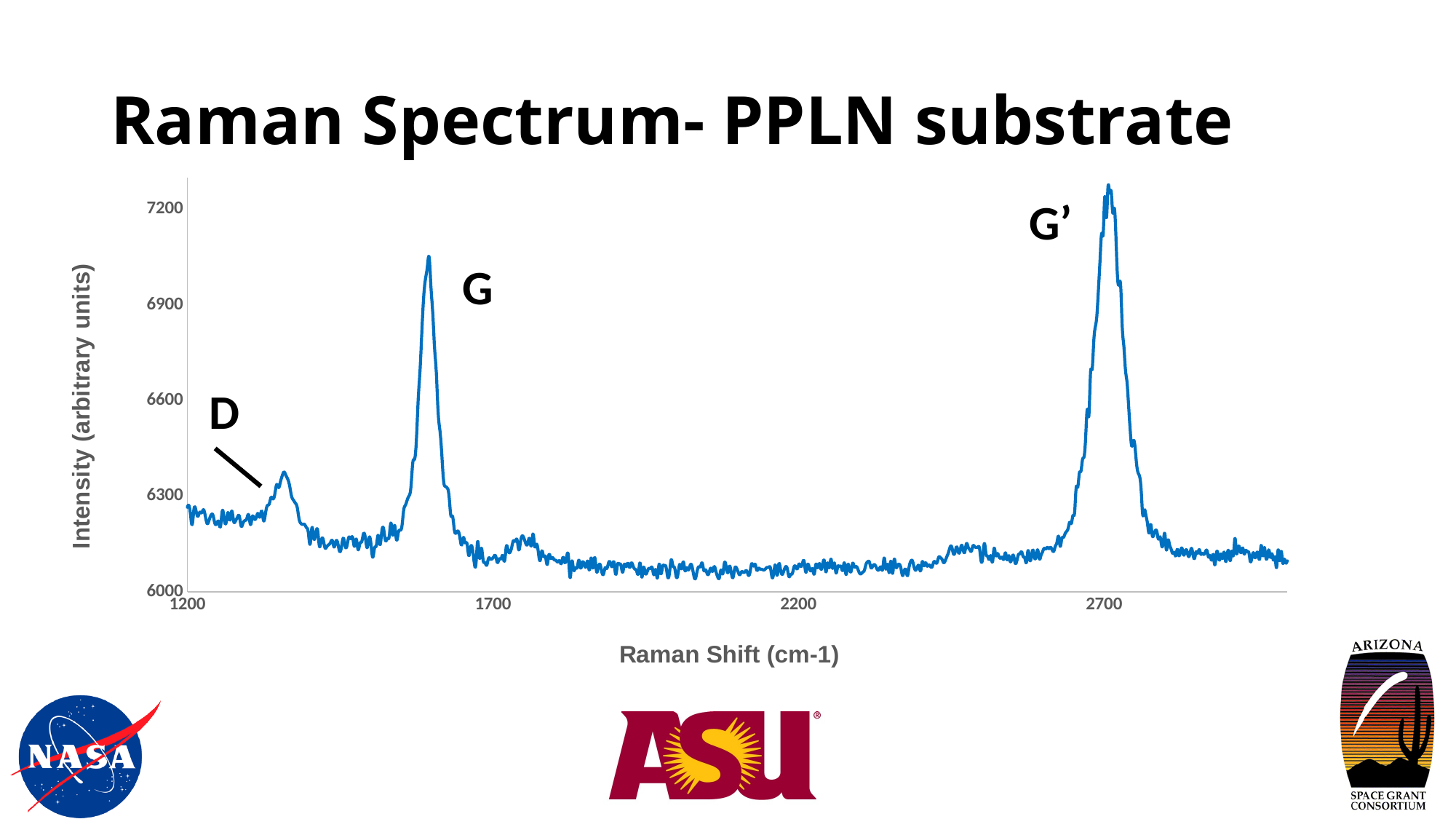
Which labeled peak has the lowest intensity? D Is the intensity at the top of the G peak greater or less than 7200? less Is the intensity at the top of the D peak greater or less than 6600? less How many peaks are labeled on the spectrum? 3 What is the title of the chart? Raman Spectrum- PPLN substrate What kind of chart is shown on the slide? Line chart Which labeled peak has the highest intensity? G' Which peak is taller, D or G? G Is the intensity at the top of the G peak greater or less than 6900? greater What is the label of the x axis? Raman Shift (cm-1) Which peak is taller, G or G'? G'